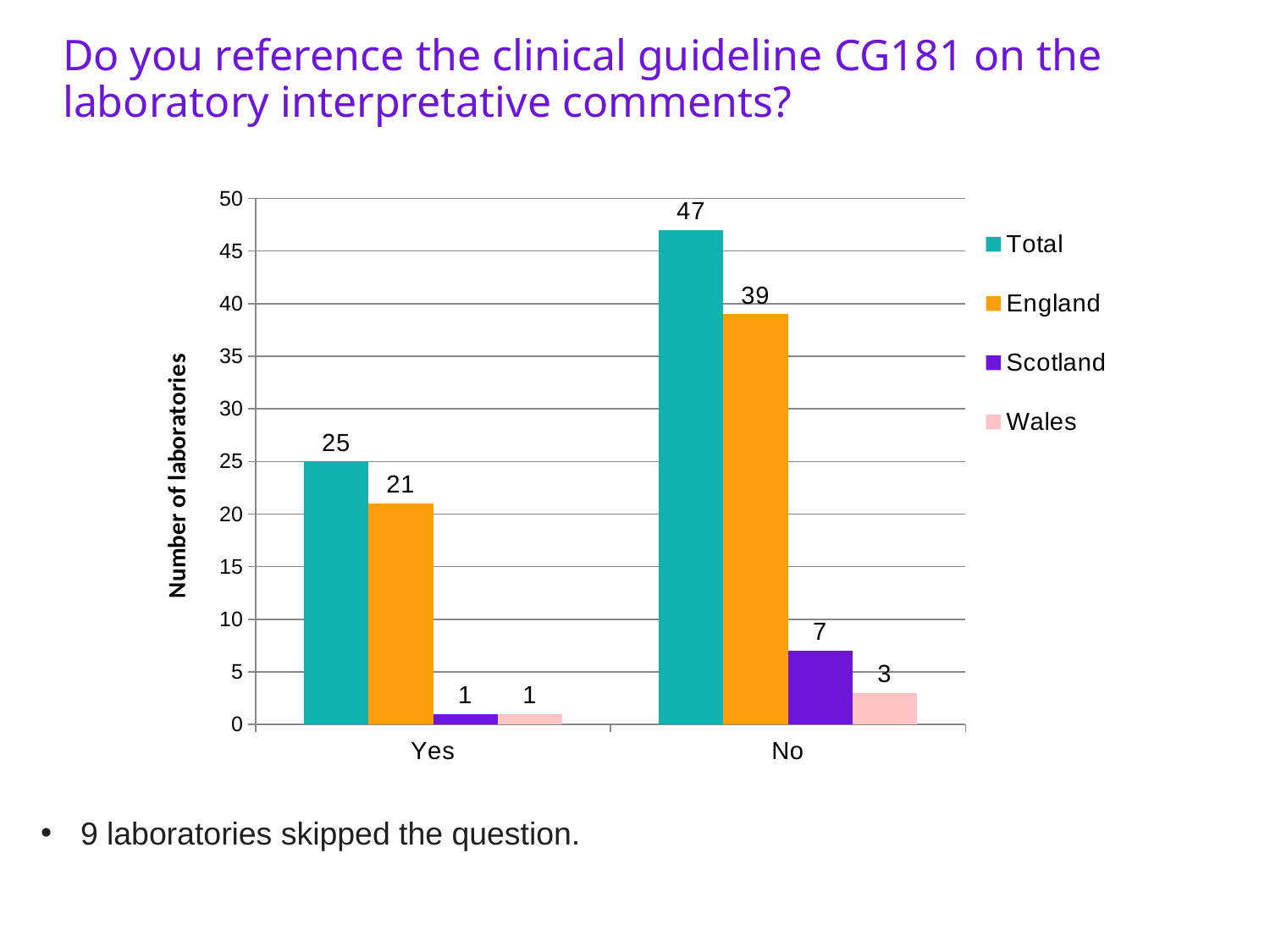
How many categories are shown on the x axis? 2 What is the Wales value for the Yes category? 1 Which category has the higher Total value, Yes or No? No What is the difference between the Total values for No and Yes? 22 What is the Total value for the No category? 47 What kind of chart is shown on the slide? Bar chart What is the label of the y axis? Number of laboratories What is the England value for the Yes category? 21 How many series does the legend list? 4 Which series has the lowest value in the No category? Wales What is the difference between the England values for No and Yes? 18 What is the Scotland value for the No category? 7